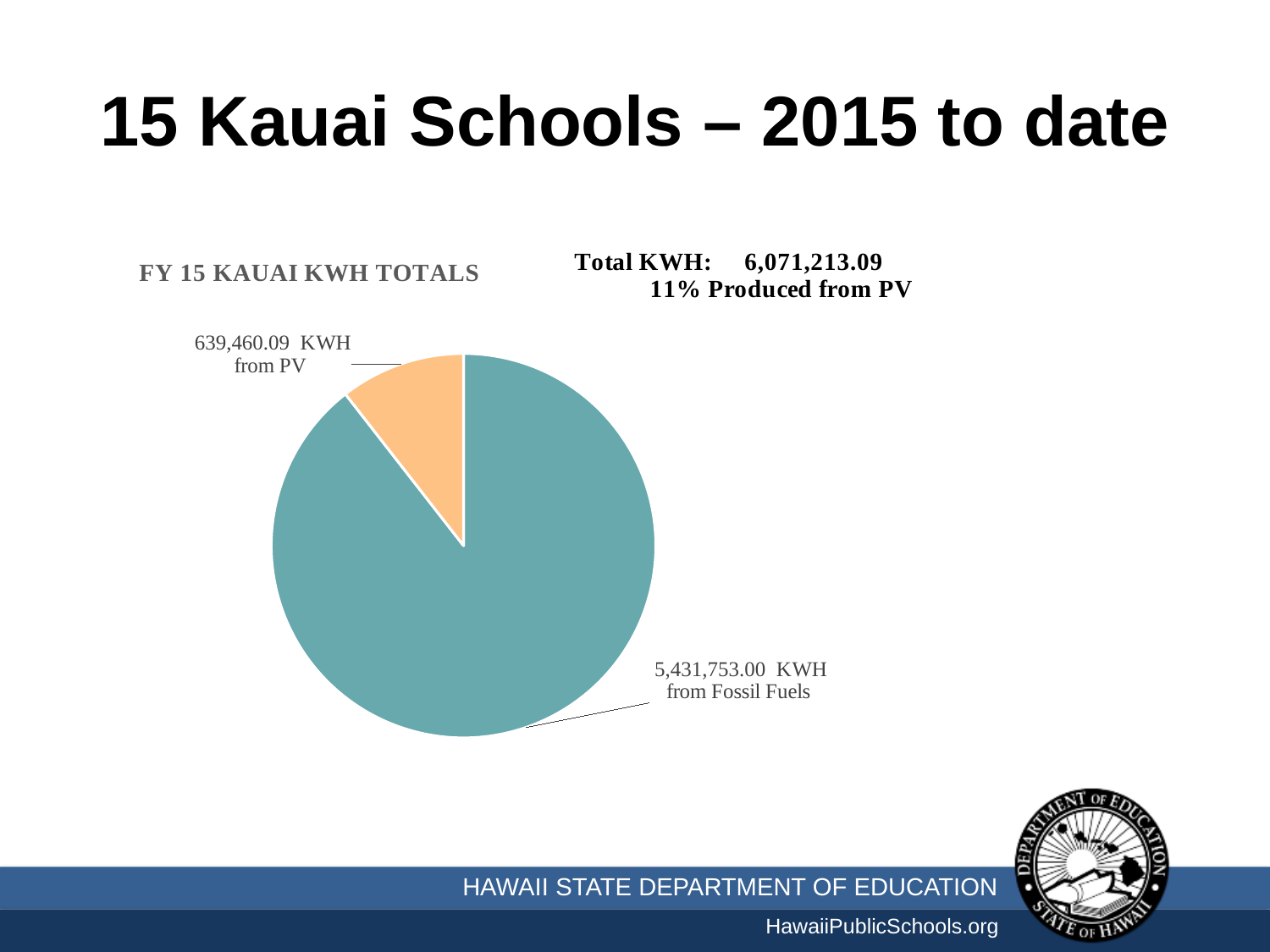
What is the title of the chart? FY 15 KAUAI KWH TOTALS Which slice of the pie is the smallest? PV Which slice of the pie is the largest? Fossil Fuels Which is larger, the KWH from PV or the KWH from Fossil Fuels? Fossil Fuels How many slices does the pie chart have? 2 How many KWH came from PV according to the chart? 639,460.09 KWH What is the total KWH shown on the slide? 6,071,213.09 What colour is the Fossil Fuels slice of the pie? Teal What is the difference in KWH between Fossil Fuels and PV? 4,792,292.91 KWH How many KWH came from Fossil Fuels according to the chart? 5,431,753.00 KWH What kind of chart is shown on the slide? Pie chart What share of the total KWH was produced from PV? 11%